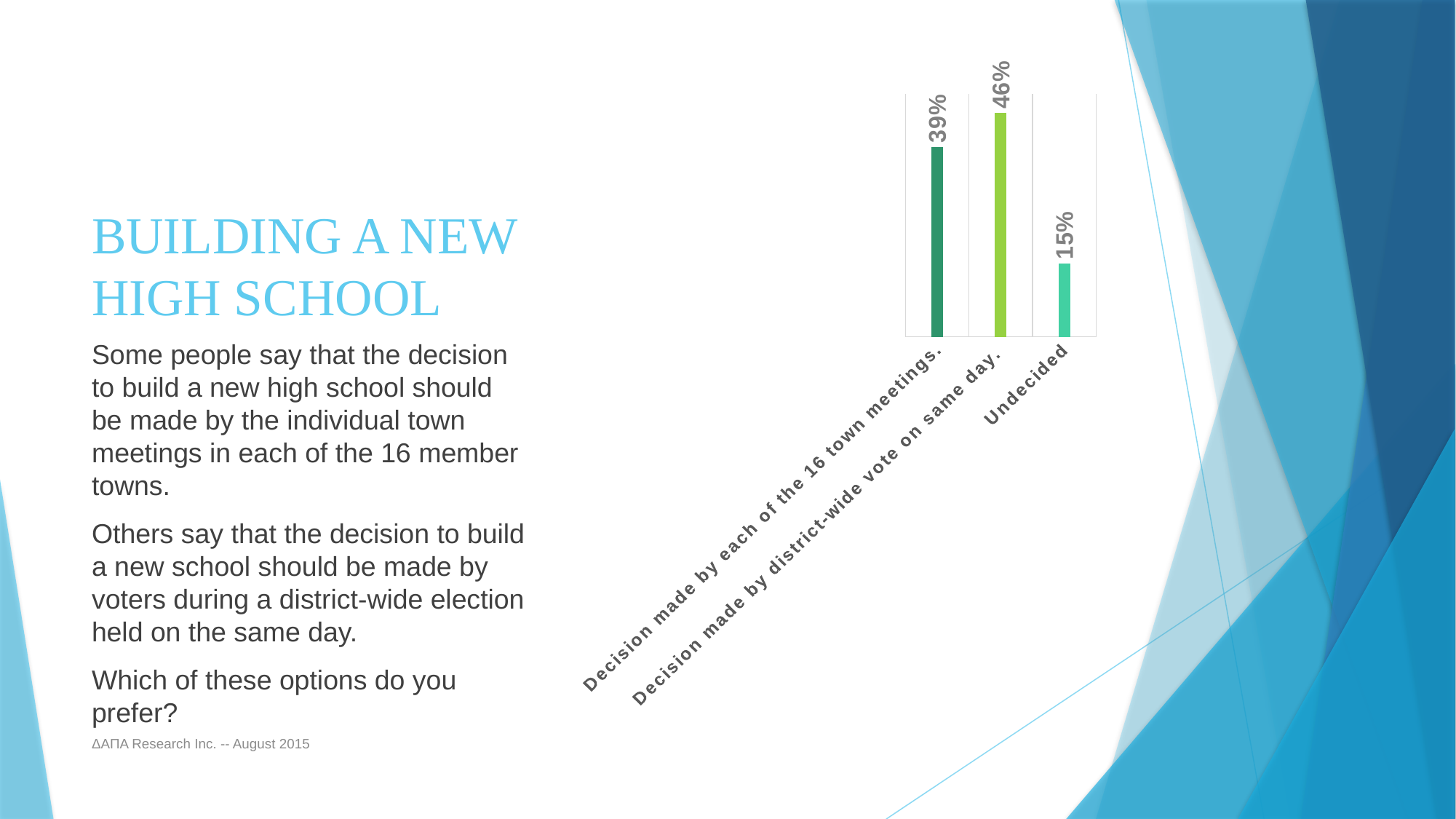
Which is larger: the percentage for town meetings or the percentage for district-wide vote? District-wide vote Which option has the highest percentage? Decision made by district-wide vote on same day. What percentage of respondents prefer the decision made by each of the 16 town meetings? 39% What percentage of respondents are undecided? 15% What is the difference between the town meetings percentage and the undecided percentage? 24% What is the difference between the district-wide vote percentage and the town meetings percentage? 7% What is the total of the three percentages shown in the chart? 100% What percentage of respondents prefer the decision made by district-wide vote on the same day? 46% What kind of chart is shown on the slide? Bar chart What is the title of the slide containing the chart? BUILDING A NEW HIGH SCHOOL How many categories are shown in the chart? 3 Which category has the lowest percentage? Undecided